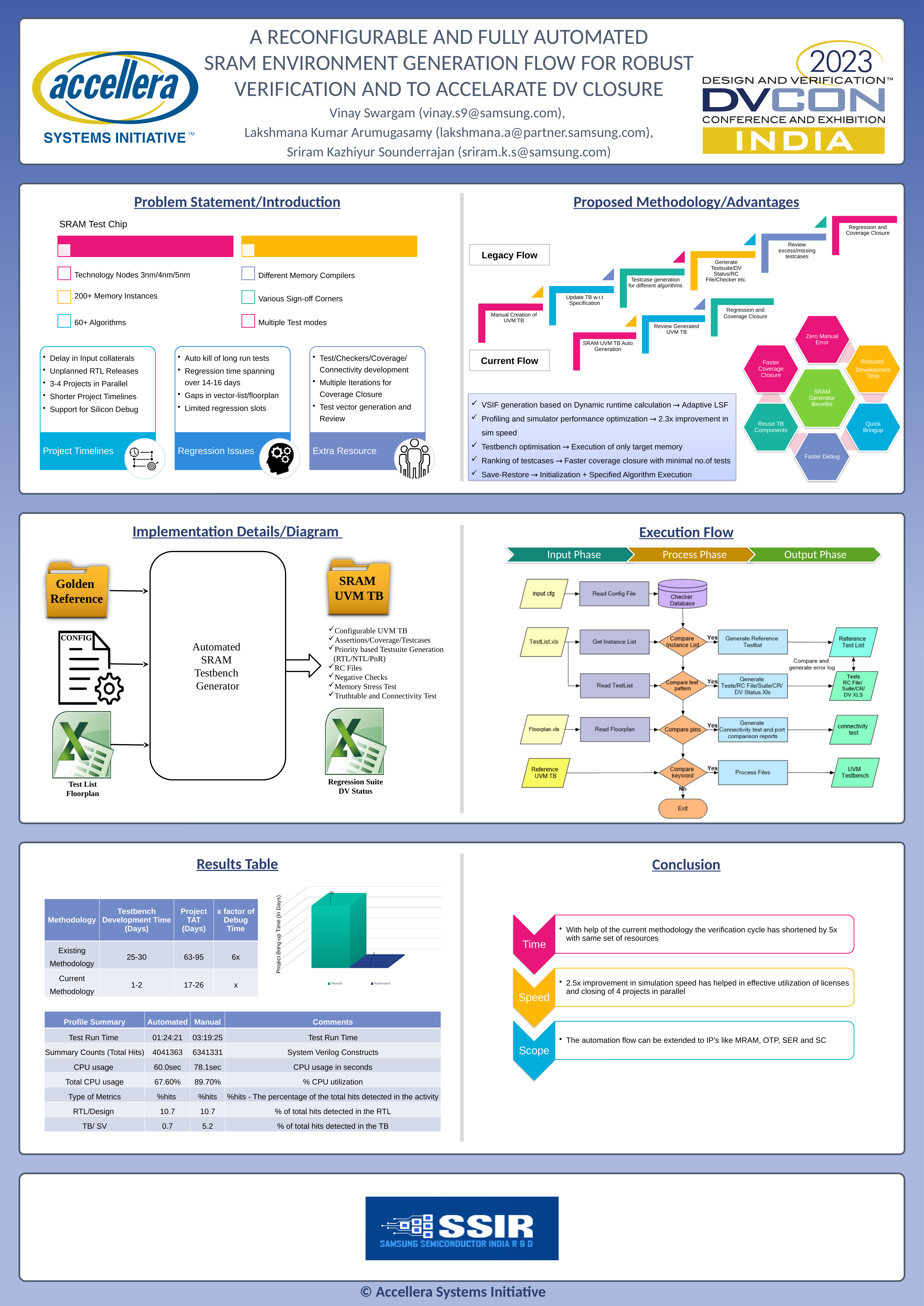
In the Results Table chart, what is the Project Bring-up Time value for Manual? 30 In the Results Table chart, what is the difference between the Manual and Automated values? 29.5 How many bars are plotted in the Results Table chart? 2 How many series does the legend of the Results Table chart list? 2 In the Results Table chart, is the Manual value larger or smaller than the Automated value? larger In the Results Table chart, which series has the lowest Project Bring-up Time? Automated What are the two legend entries in the Results Table chart? Manual and Automated What is the y-axis title of the Results Table chart? Project Bring-up Time (In Days) What kind of chart is shown in the Results Table section? bar chart In the Results Table chart, which series has the highest Project Bring-up Time? Manual In the Results Table chart, what is the Project Bring-up Time value for Automated? 0.5